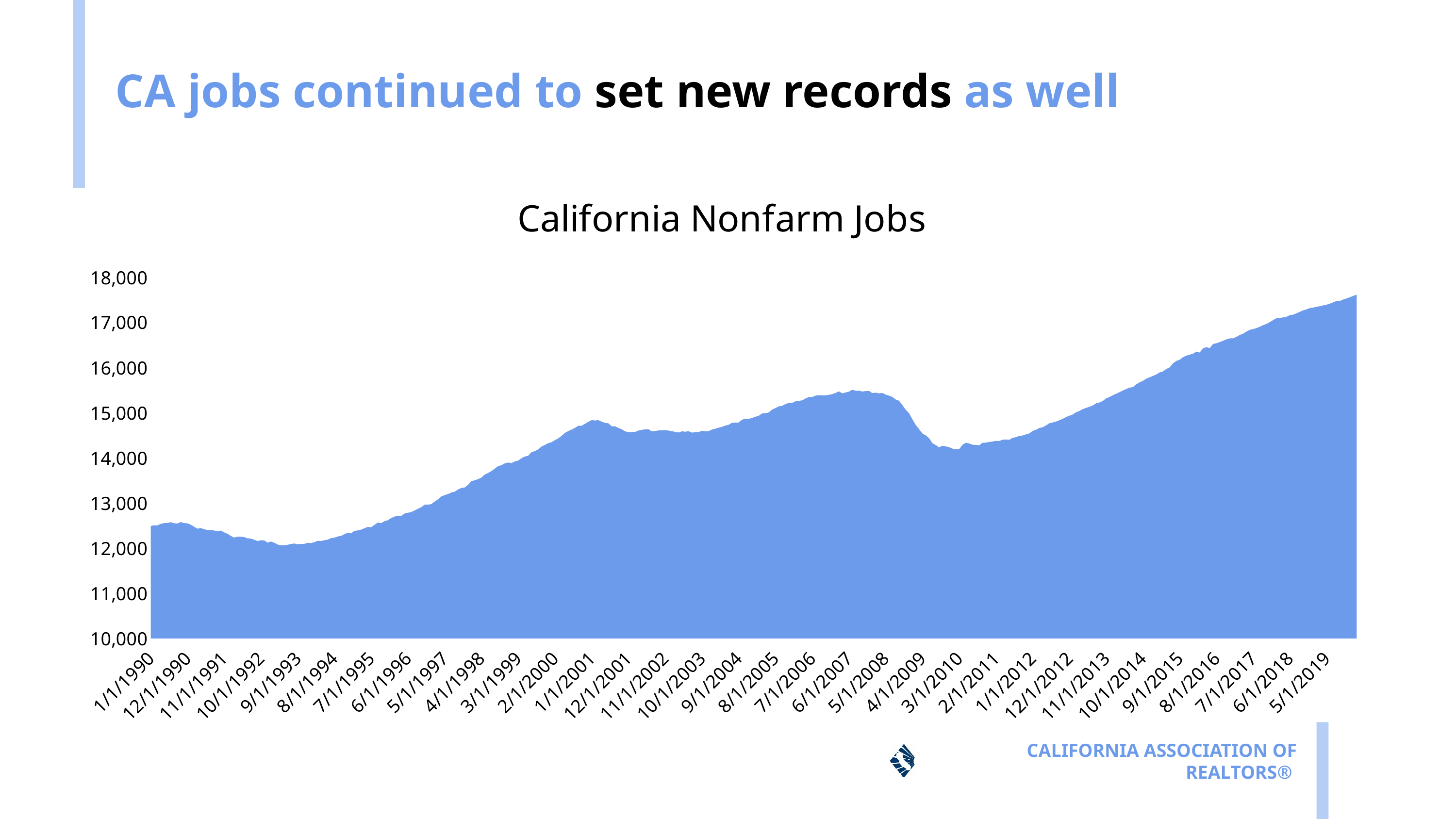
What kind of chart is shown on the slide? Area chart What is the title of the chart? California Nonfarm Jobs Is the value for 3/1/2010 greater or less than 15,000? less What is the highest value shown on the vertical axis? 18,000 Is the value for 2/1/2000 greater or less than 14,000? greater Is the value for 1/1/1990 greater or less than 13,000? less Which is larger, the value for 1/1/1990 or the value for 5/1/2019? 5/1/2019 Which is larger, the value for 6/1/2007 or the value for 3/1/2010? 6/1/2007 Overall, do California nonfarm jobs rise or fall from 1/1/1990 to 5/1/2019? Rise